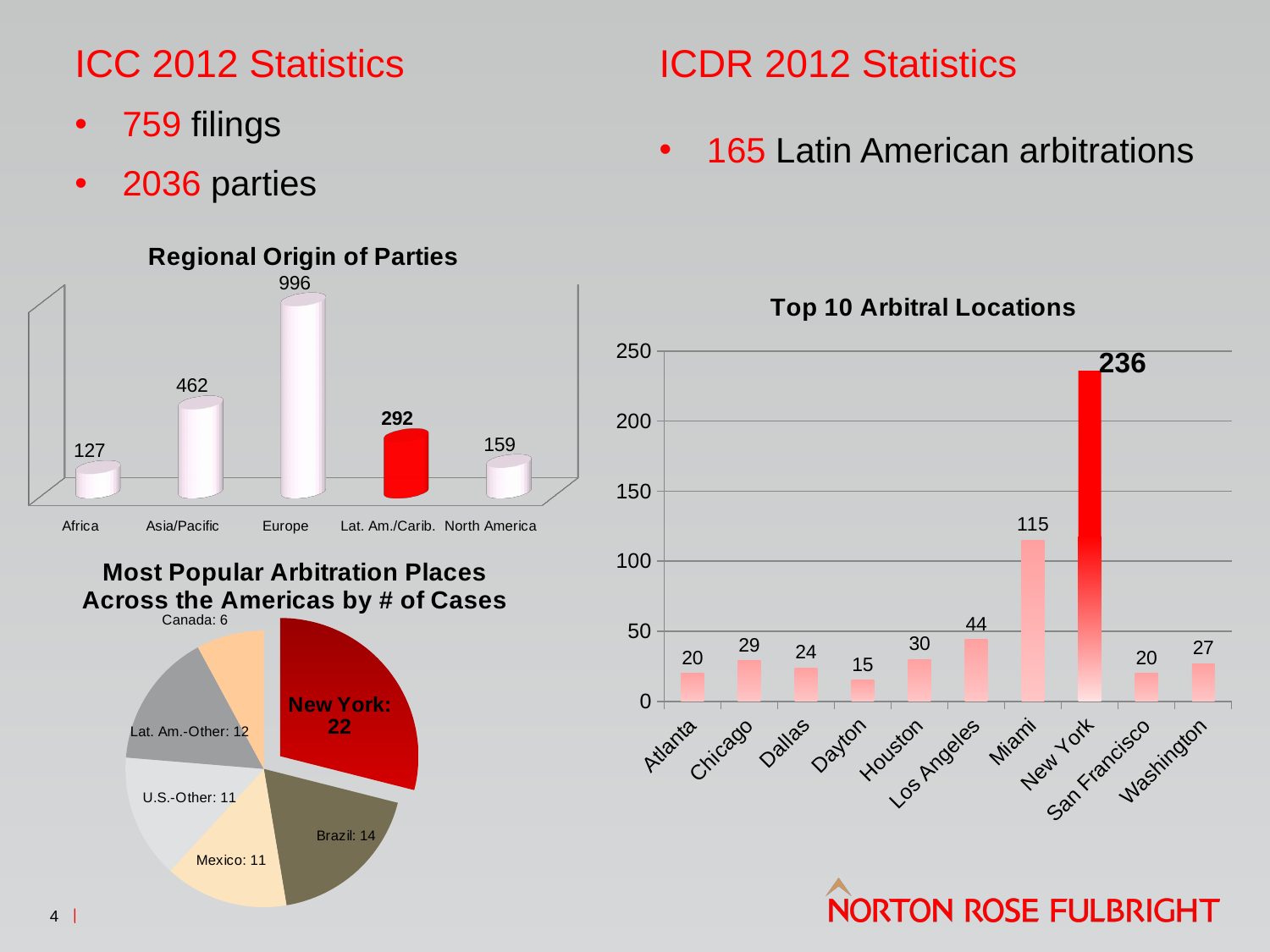
In the 'Regional Origin of Parties' chart, what is the difference between Asia/Pacific and Lat. Am./Carib.? 170 In the 'Regional Origin of Parties' chart, which region has the lowest value? Africa In the 'Regional Origin of Parties' chart, what is the value for Europe? 996 In the 'Most Popular Arbitration Places Across the Americas by # of Cases' pie chart, which slice is the largest? New York In the 'Top 10 Arbitral Locations' chart, what is the difference between New York and Miami? 121 How many regions are shown in the 'Regional Origin of Parties' chart? 5 In the 'Most Popular Arbitration Places Across the Americas by # of Cases' pie chart, how many cases does Brazil have? 14 In the 'Top 10 Arbitral Locations' chart, which location has the lowest value? Dayton In the 'Top 10 Arbitral Locations' chart, what is the value for Miami? 115 What kind of chart is 'Top 10 Arbitral Locations'? Bar chart In the 'Top 10 Arbitral Locations' chart, which is larger, Houston or Chicago? Houston In the 'Top 10 Arbitral Locations' chart, which location has the highest value? New York